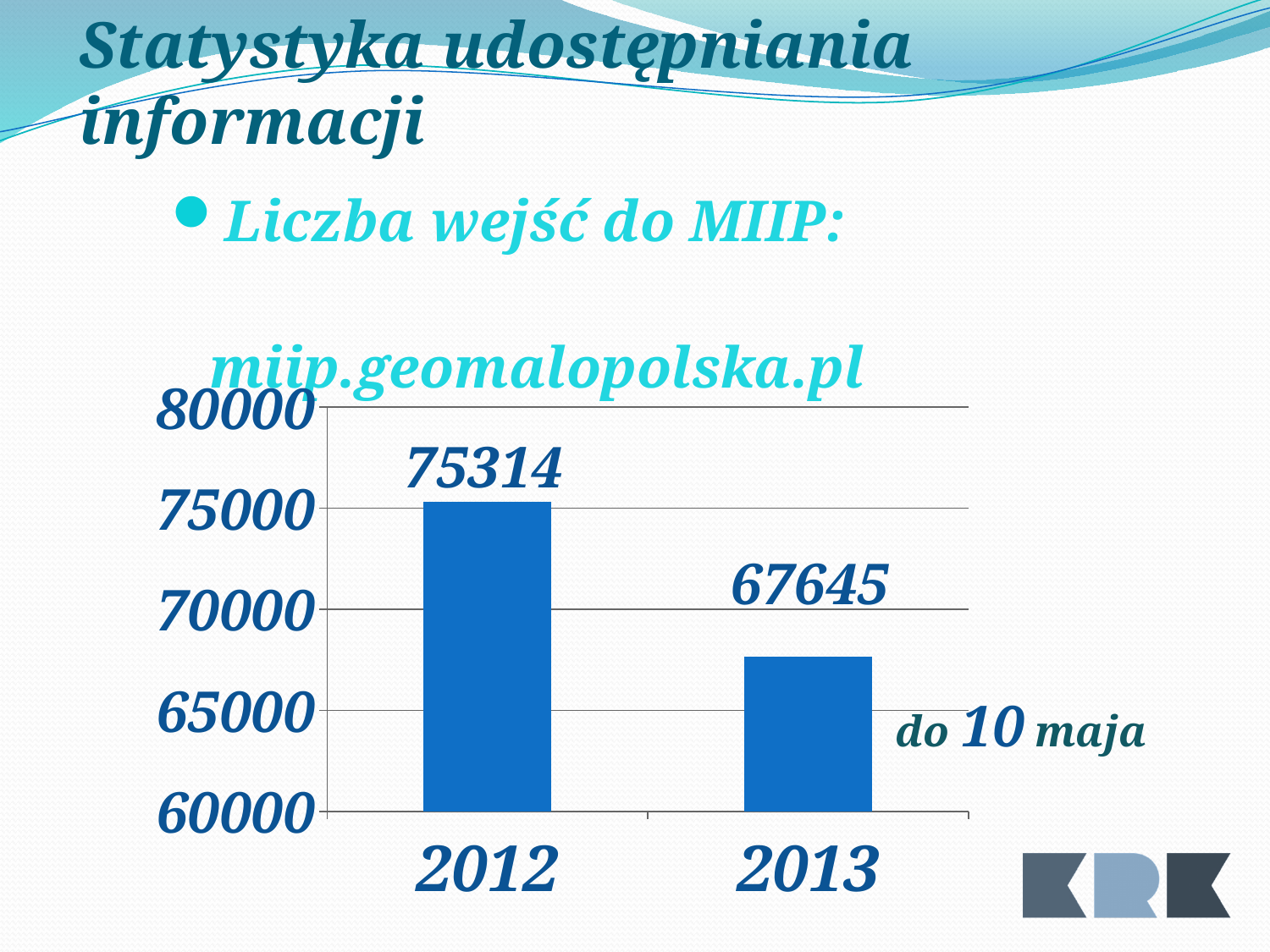
What is the difference between the 2012 and 2013 values? 7669 Which year has the lower value? 2013 Is the value for 2013 greater or less than 70000? less Which year has the higher value? 2012 Is the value for 2012 greater or less than the value for 2013? greater How many bars are shown in the chart? 2 What is the value for 2012? 75314 What kind of chart is shown on the slide? bar chart What is the value for 2013? 67645 What note is written next to the 2013 bar? do 10 maja Do the values rise or fall from 2012 to 2013? fall Is the value for 2012 greater or less than 75000? greater